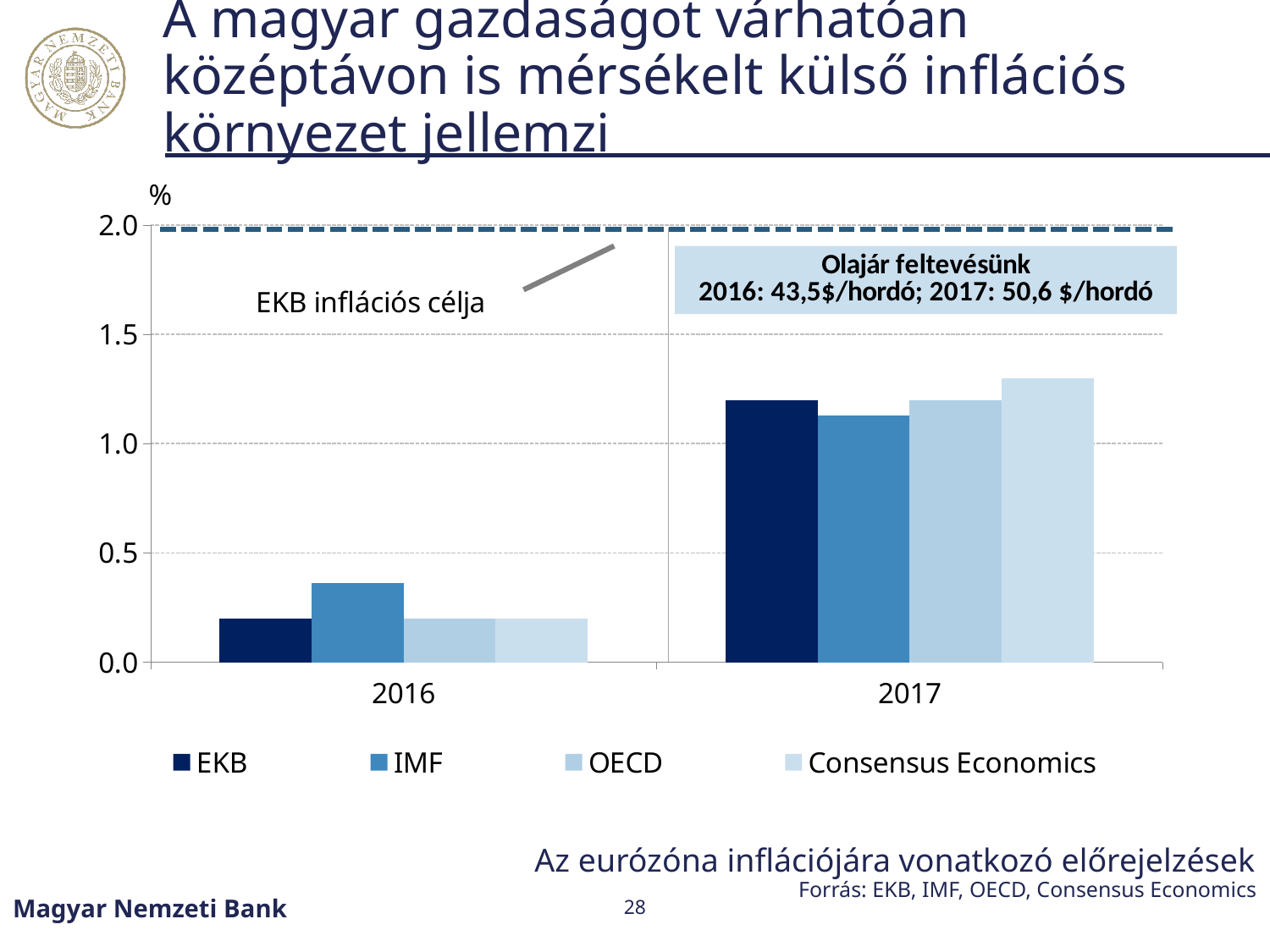
How many series does the legend list? 4 Is the value for IMF in 2016 greater or less than 0.5? less How many year categories are shown on the x axis? 2 What does the dashed horizontal line at 2.0 represent, according to its label? EKB inflációs célja What kind of chart is shown on the slide? Bar chart Which series has the highest value for 2017? Consensus Economics Is the value for EKB in 2017 greater or less than 1.0? greater Do the forecast values rise or fall from 2016 to 2017? rise Which series has the lowest value for 2017? IMF Which is larger, the EKB value for 2016 or the EKB value for 2017? 2017 Is the value for Consensus Economics in 2017 greater or less than 1.5? less Which series has the highest value for 2016? IMF